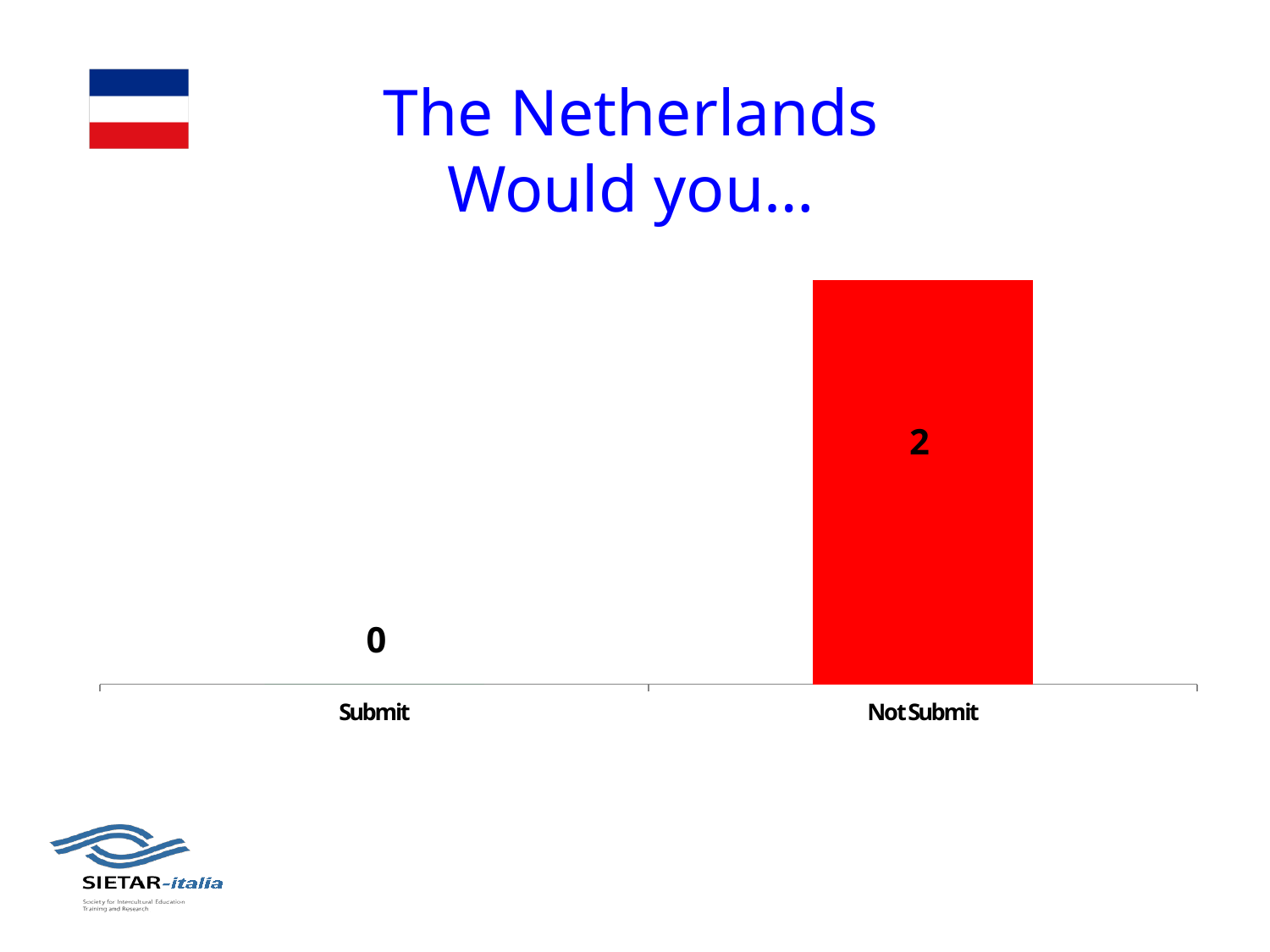
How many categories are shown on the x axis? 2 Which is larger, the value for Submit or the value for Not Submit? Not Submit What is the title shown above the chart? The Netherlands Would you... Which category has the highest value? Not Submit What colour is the bar for Not Submit? red Which category has the lowest value? Submit What kind of chart is shown on the slide? bar chart What is the difference between the values for Not Submit and Submit? 2 What is the value for Submit? 0 What is the value for Not Submit? 2 Do the values rise or fall from Submit to Not Submit? rise